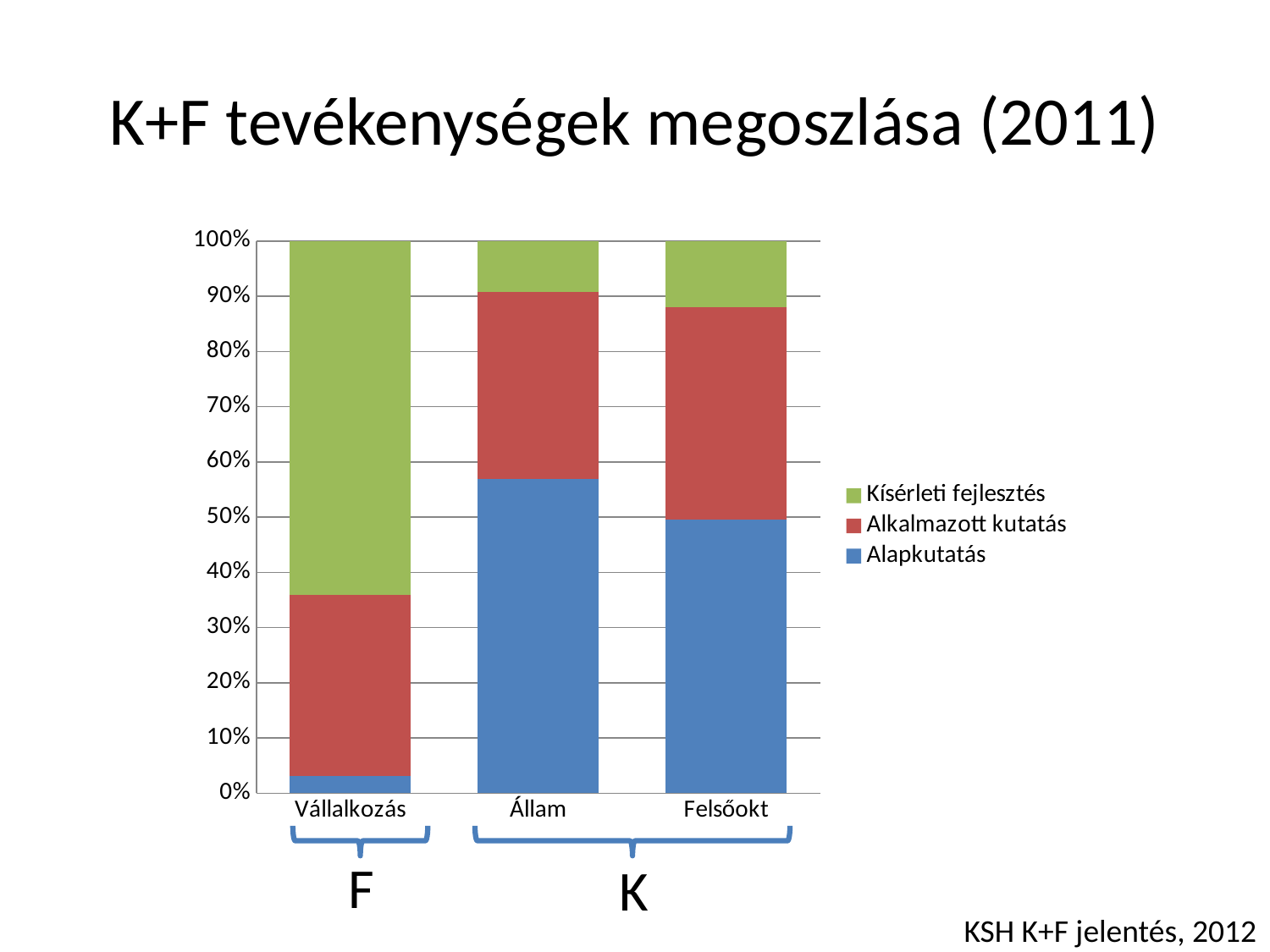
How many series does the chart's legend list? 3 Which category has the largest Alapkutatás share? Állam Which has the larger Alapkutatás share, Állam or Felsőokt? Állam What is the title of the chart on the slide? K+F tevékenységek megoszlása (2011) How many categories are shown on the x axis of the chart? 3 Which category has the largest Kísérleti fejlesztés share? Vállalkozás What is the total of each stacked bar in the chart? 100% Is the Alapkutatás share for Állam greater or less than 50%? greater What kind of chart is shown on the slide? Stacked bar chart Is the Kísérleti fejlesztés share for Vállalkozás greater or less than 60%? greater Is the Alapkutatás share for Vállalkozás greater or less than 10%? less Which category has the smallest Alapkutatás share? Vállalkozás